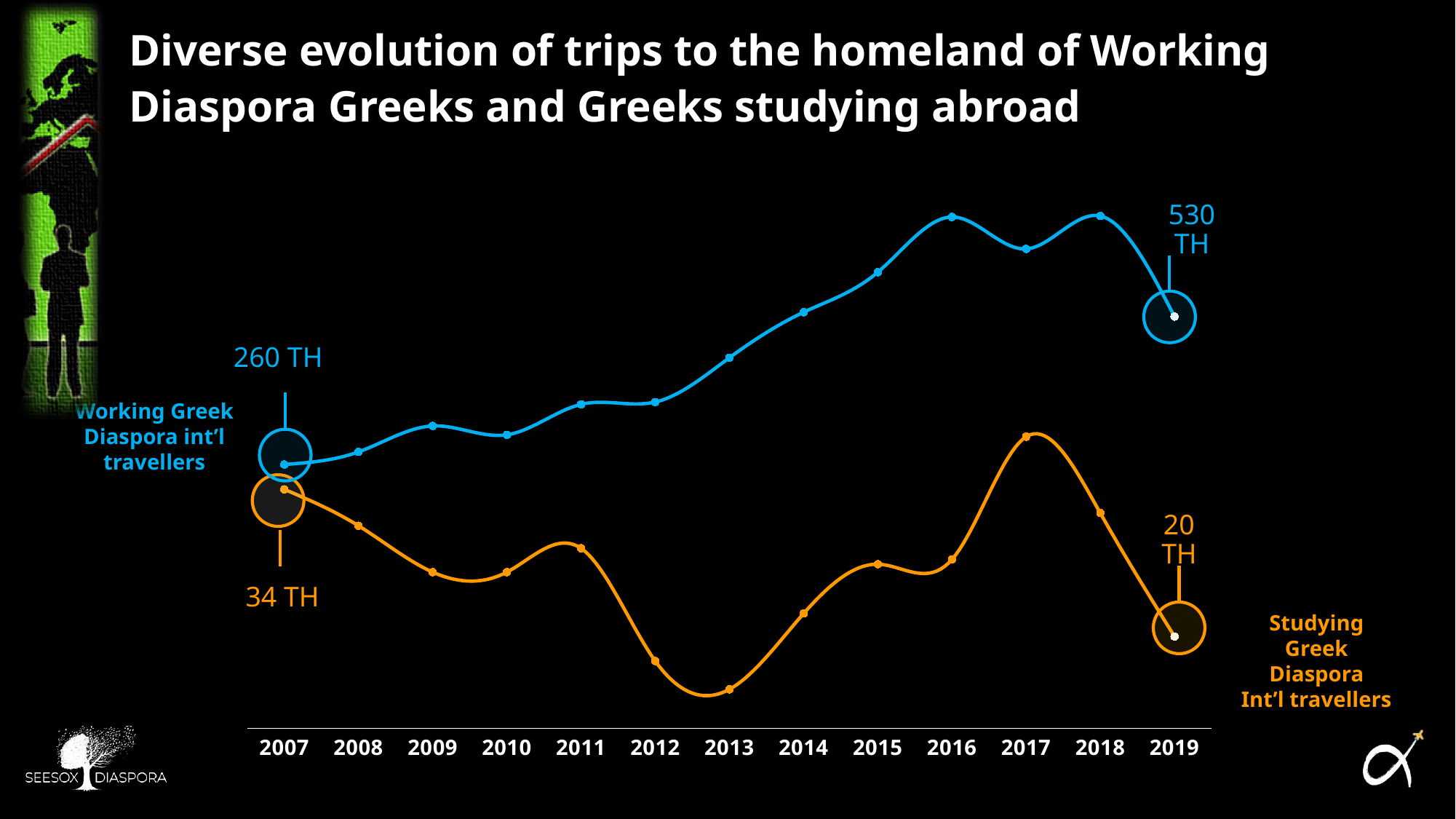
What is the value for Studying Greek Diaspora Int'l travellers in 2007? 34 TH In which year does the Studying Greek Diaspora Int'l travellers line reach its lowest point? 2013 What is the value for Working Greek Diaspora int'l travellers in 2019? 530 TH What type of chart is shown on the slide? Line chart In which year does the Studying Greek Diaspora Int'l travellers line reach its highest point? 2017 What is the value for Studying Greek Diaspora Int'l travellers in 2019? 20 TH By how much did the Working Greek Diaspora int'l travellers value increase from 2007 to 2019? 270 TH What is the value for Working Greek Diaspora int'l travellers in 2007? 260 TH In 2019, which series has the larger value: Working Greek Diaspora int'l travellers or Studying Greek Diaspora Int'l travellers? Working Greek Diaspora int'l travellers Overall, does the Working Greek Diaspora int'l travellers line rise or fall from 2007 to 2019? Rise By how much did the Studying Greek Diaspora Int'l travellers value decrease from 2007 to 2019? 14 TH How many years are shown on the x axis? 13